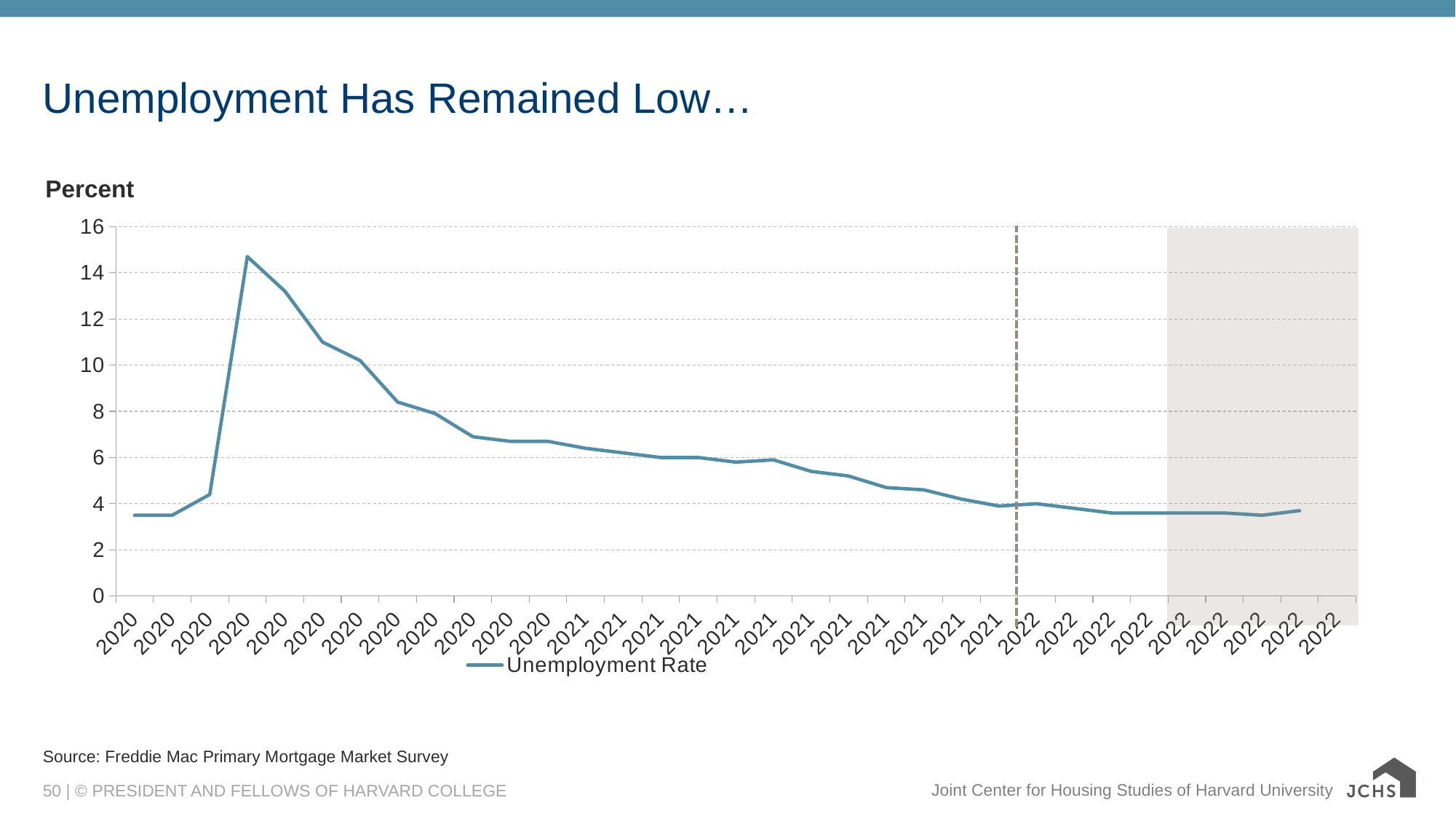
Is the peak value of the Unemployment Rate line greater or less than 14? greater Which is higher: the Unemployment Rate at its 2020 peak or at the end of 2021? the 2020 peak Is the value of the Unemployment Rate at the last plotted point in 2022 greater or less than 4? less Is the Unemployment Rate at the start of 2021 greater or less than 6? greater What kind of chart is shown on the slide? line chart How many series does the legend list? 1 After its peak in 2020, does the Unemployment Rate generally rise or fall through 2021? fall What is the title of the slide's chart? Unemployment Has Remained Low… What is the highest value shown on the vertical axis? 16 In which year does the Unemployment Rate reach its highest point? 2020 What is the name of the series shown in the legend? Unemployment Rate